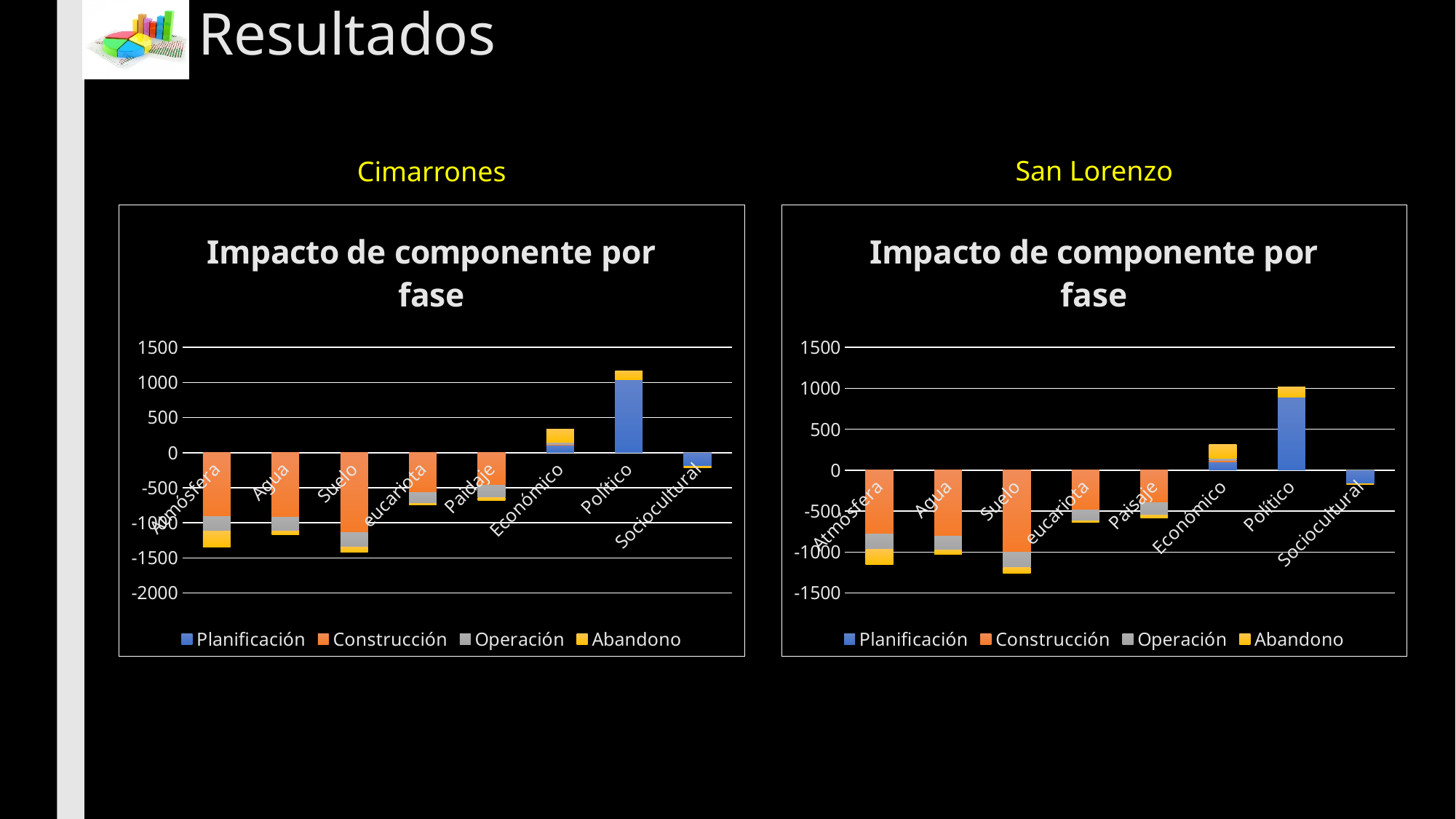
In the Cimarrones chart, is the total stacked value for Suelo greater or less than -1000? less In the San Lorenzo chart, is the total stacked value for Económico greater or less than 500? less In the Cimarrones chart, which category has the highest positive stacked value? Político How many series does the legend of the San Lorenzo chart list? 4 In the Cimarrones chart, which is larger, the stacked value for Político or for Económico? Político How many categories are shown on the x axis of the Cimarrones chart? 8 What kind of chart is the Cimarrones chart titled 'Impacto de componente por fase'? Stacked bar chart What is the title of the chart under the Cimarrones heading? Impacto de componente por fase Which series is shown in orange in the legend of the San Lorenzo chart? Construcción In the San Lorenzo chart, is the total stacked value for Suelo greater or less than -1000? less In the San Lorenzo chart, which category has the highest positive stacked value? Político